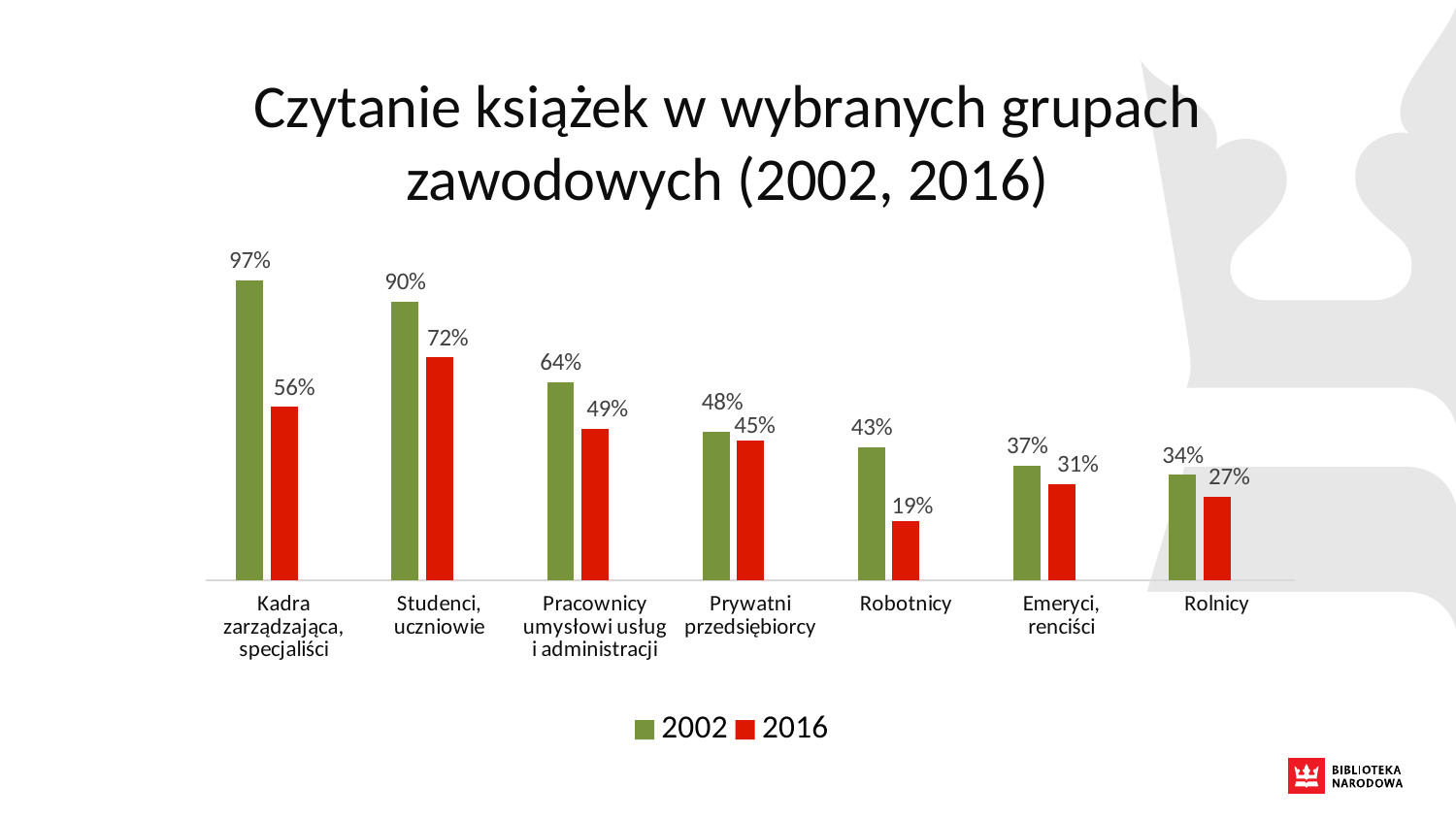
How many series does the legend list? 2 What is the 2016 value for Studenci, uczniowie? 72% How many categories are shown on the x axis? 7 What is the difference between the 2002 and 2016 values for Robotnicy? 24% What kind of chart is shown on the slide? Bar chart What is the difference between the 2002 and 2016 values for Kadra zarządzająca, specjaliści? 41% What is the 2016 value for Robotnicy? 19% Which category has the lowest 2016 value? Robotnicy Which is larger: the 2016 value for Emeryci, renciści or the 2016 value for Rolnicy? Emeryci, renciści Which colour represents the 2016 series? Red What is the 2002 value for Kadra zarządzająca, specjaliści? 97% Which category has the highest 2002 value? Kadra zarządzająca, specjaliści